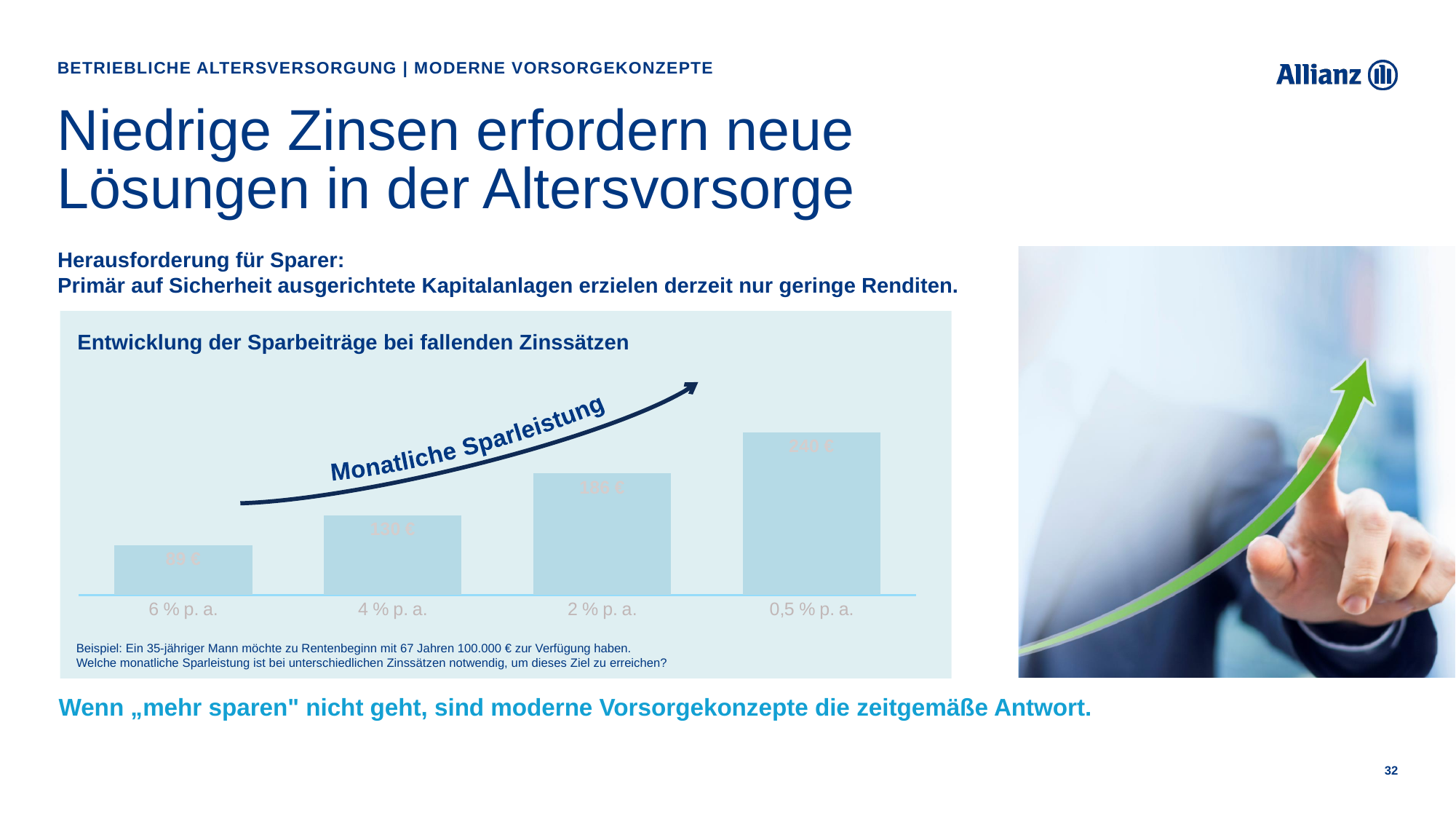
Do the bars rise or fall from left to right along the x axis? rise What kind of chart is shown under the heading 'Entwicklung der Sparbeiträge bei fallenden Zinssätzen'? bar chart What is the category label of the leftmost bar? 6 % p. a. How many bars (interest-rate categories) does the chart show? 4 Which interest-rate category has the lowest bar in the chart? 6 % p. a. Which bar is taller: the one for 4 % p. a. or the one for 2 % p. a.? 2 % p. a. What is the category label of the rightmost bar? 0,5 % p. a. Which interest-rate category has the highest bar in the chart? 0,5 % p. a. What is the title of the chart? Entwicklung der Sparbeiträge bei fallenden Zinssätzen Which bar is taller: the one for 6 % p. a. or the one for 0,5 % p. a.? 0,5 % p. a. What label is written along the curved arrow above the bars? Monatliche Sparleistung